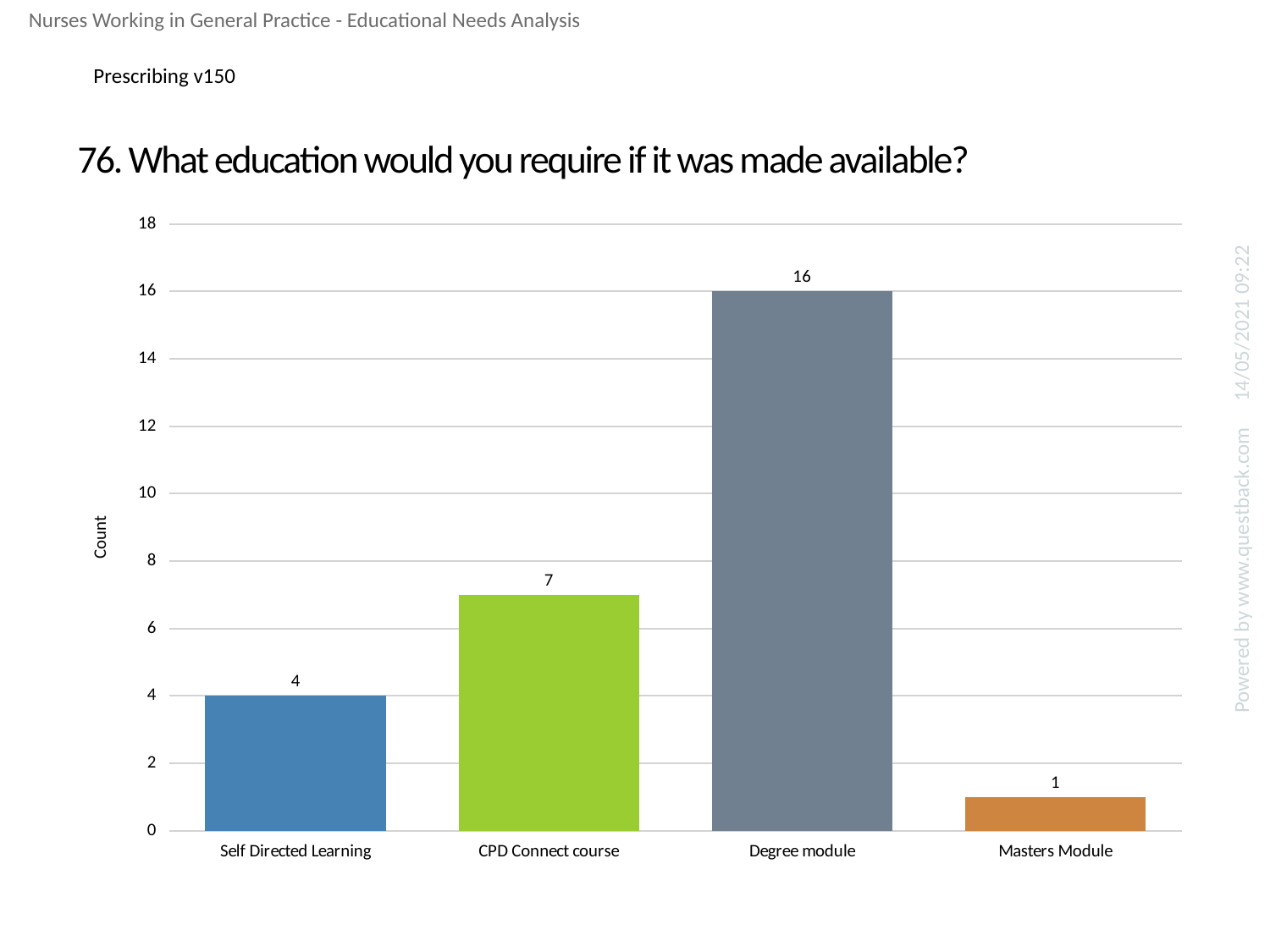
What kind of chart is shown on the slide? bar chart What is the count for Degree module? 16 Which category has the lowest count? Masters Module How many categories are shown on the x axis? 4 Which category has the highest count? Degree module Is the count for Degree module greater or less than 10? greater What is the count for Self Directed Learning? 4 What is the count for Masters Module? 1 What is the count for CPD Connect course? 7 What is the difference between the counts for Degree module and CPD Connect course? 9 What is the label of the y axis? Count Which has a larger count, Self Directed Learning or CPD Connect course? CPD Connect course